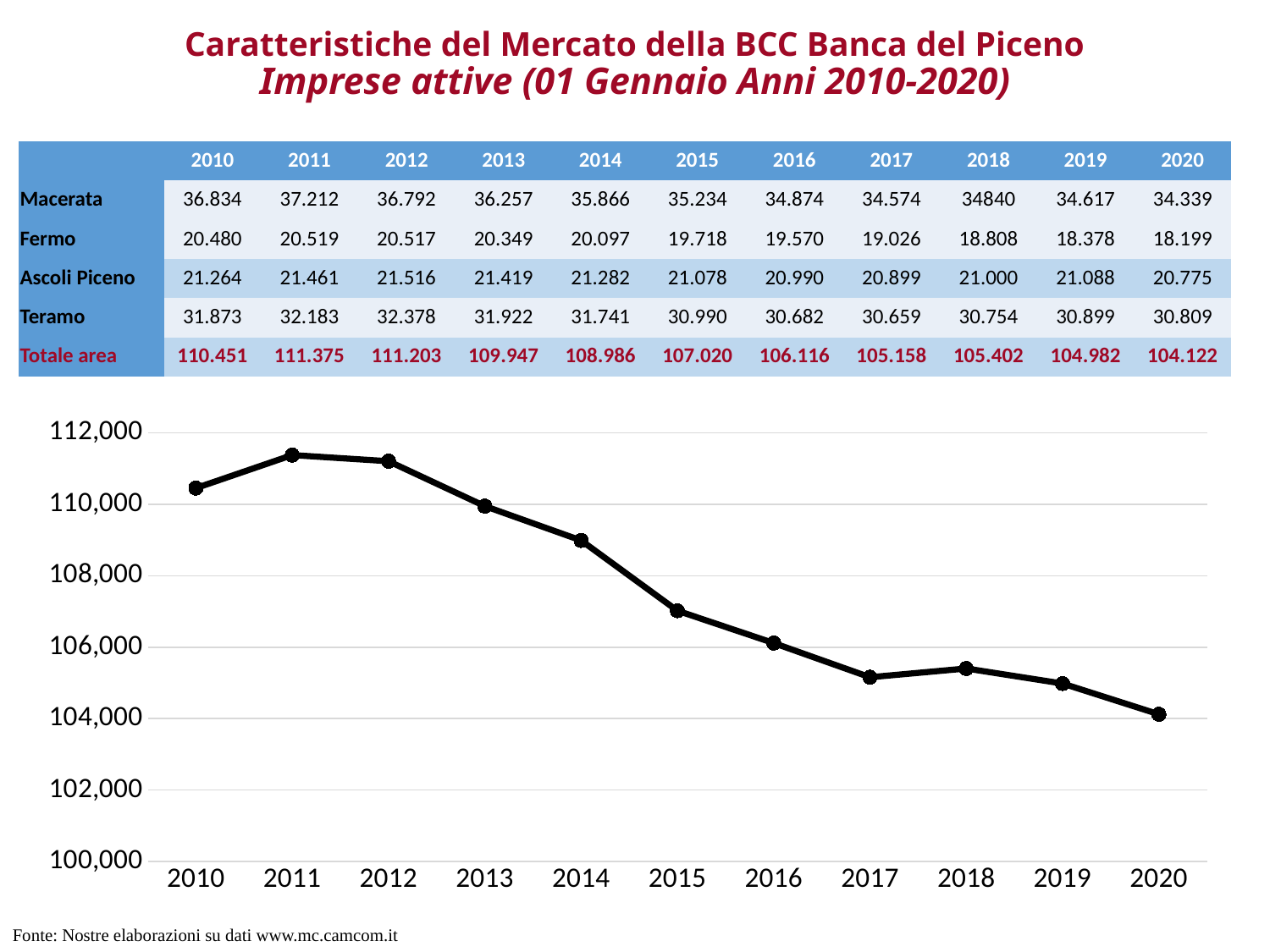
In which year does the line chart reach its highest value? 2011 What is the lowest value shown on the vertical axis of the line chart? 100,000 Which year has the larger plotted value, 2012 or 2013? 2012 Which year has the larger plotted value, 2017 or 2018? 2018 Do the values on the line chart generally rise or fall from 2010 to 2020? fall What kind of chart is shown on the slide? line chart Is the value plotted for 2019 greater or less than 106,000? less What is the Totale area value for 2010 shown in the table and plotted on the chart? 110.451 In which year does the line chart reach its lowest value? 2020 Is the value plotted for 2014 greater or less than 108,000? greater How many data points are plotted on the line chart? 11 Is the value plotted for 2015 greater or less than 108,000? less